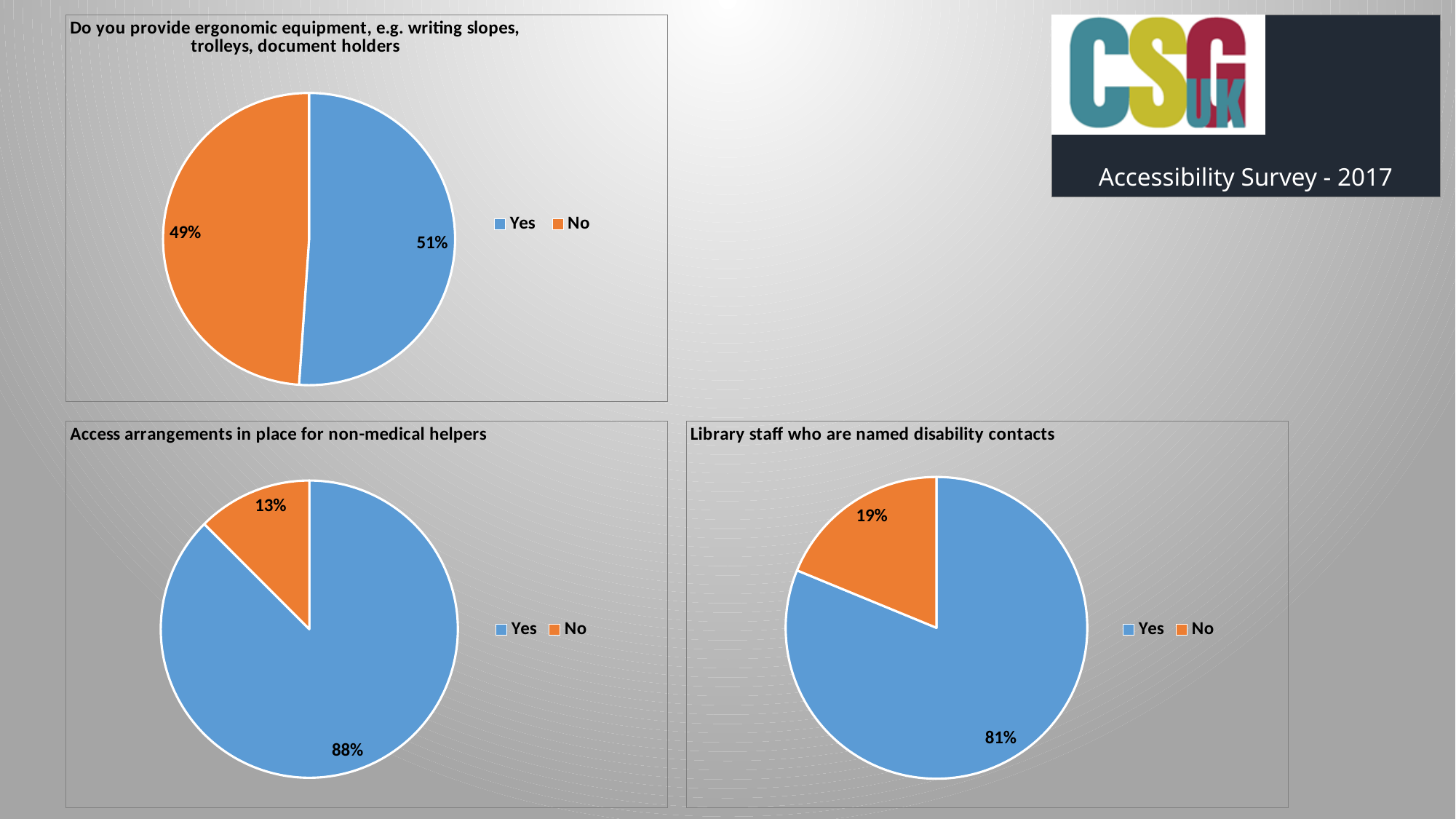
In the chart titled 'Library staff who are named disability contacts', what colour is the Yes slice? Blue In the chart titled 'Access arrangements in place for non-medical helpers', which response has the smallest slice? No In the chart titled 'Library staff who are named disability contacts', what share of respondents answered Yes? 81% In the chart titled 'Library staff who are named disability contacts', what is the difference in percentage points between the Yes and No slices? 62 In the chart titled 'Access arrangements in place for non-medical helpers', what share of respondents answered No? 13% In the chart titled 'Library staff who are named disability contacts', which response has the largest slice? Yes In the chart titled 'Do you provide ergonomic equipment, e.g. writing slopes, trolleys, document holders', what share of respondents answered No? 49% What kind of chart is the chart titled 'Access arrangements in place for non-medical helpers'? Pie chart How many slices does the chart titled 'Do you provide ergonomic equipment, e.g. writing slopes, trolleys, document holders' have? 2